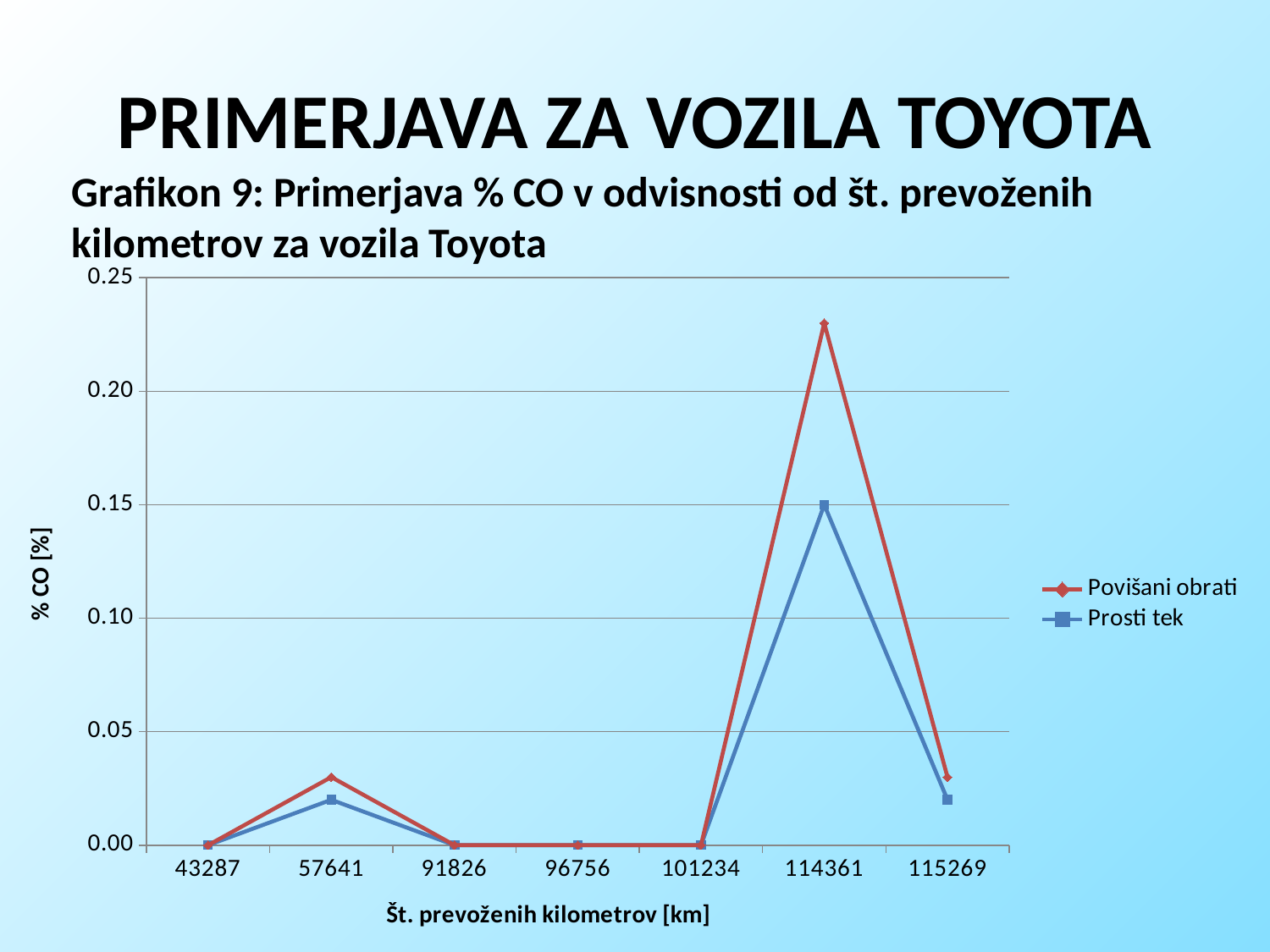
Do the values rise or fall from 114361 km to 115269 km? fall What is the Povišani obrati value at 96756 km? 0.00 What is the Prosti tek value at 43287 km? 0.00 At which number of kilometres is the Prosti tek value highest? 114361 How many kilometre categories are shown on the x axis? 7 What is the Prosti tek value at 114361 km? 0.15 At 114361 km, which series has the larger value, Povišani obrati or Prosti tek? Povišani obrati Is the Povišani obrati value at 114361 km greater or less than 0.20? greater Is the Povišani obrati value at 57641 km greater or less than 0.05? less What kind of chart is shown on the slide? line chart How many series does the legend list? 2 At which number of kilometres is the Povišani obrati value highest? 114361